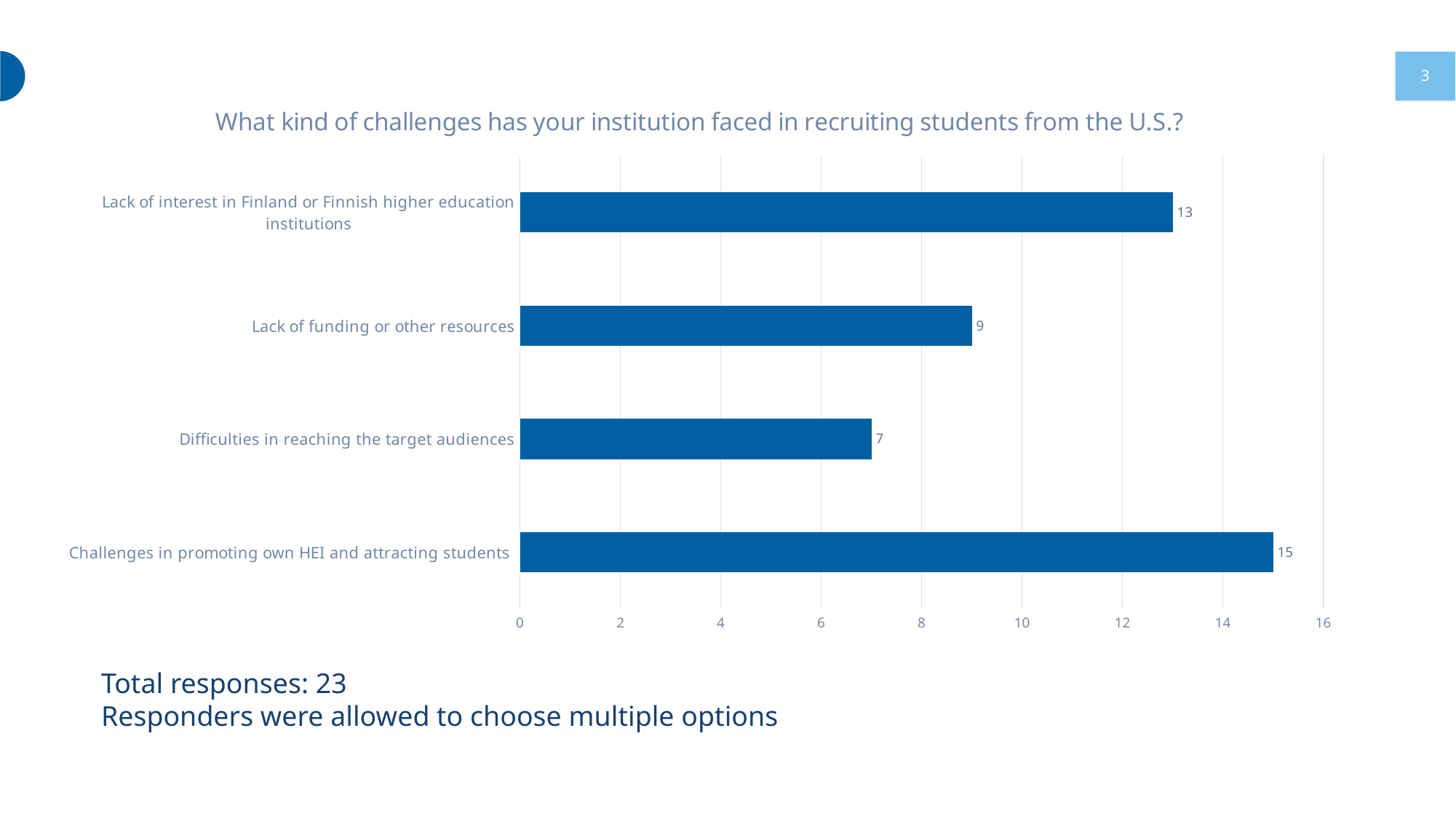
Which is larger: the value for "Lack of funding or other resources" or the value for "Difficulties in reaching the target audiences"? Lack of funding or other resources What is the value for "Lack of interest in Finland or Finnish higher education institutions"? 13 How many categories are shown in the chart? 4 What is the difference between the values for "Challenges in promoting own HEI and attracting students" and "Difficulties in reaching the target audiences"? 8 What kind of chart is shown on the slide? Bar chart What is the value for "Lack of funding or other resources"? 9 What is the value for "Challenges in promoting own HEI and attracting students"? 15 What is the value for "Difficulties in reaching the target audiences"? 7 What is the title of the chart? What kind of challenges has your institution faced in recruiting students from the U.S.? What is the difference between the values for "Lack of interest in Finland or Finnish higher education institutions" and "Lack of funding or other resources"? 4 Which category has the lowest value? Difficulties in reaching the target audiences Which category has the highest value? Challenges in promoting own HEI and attracting students